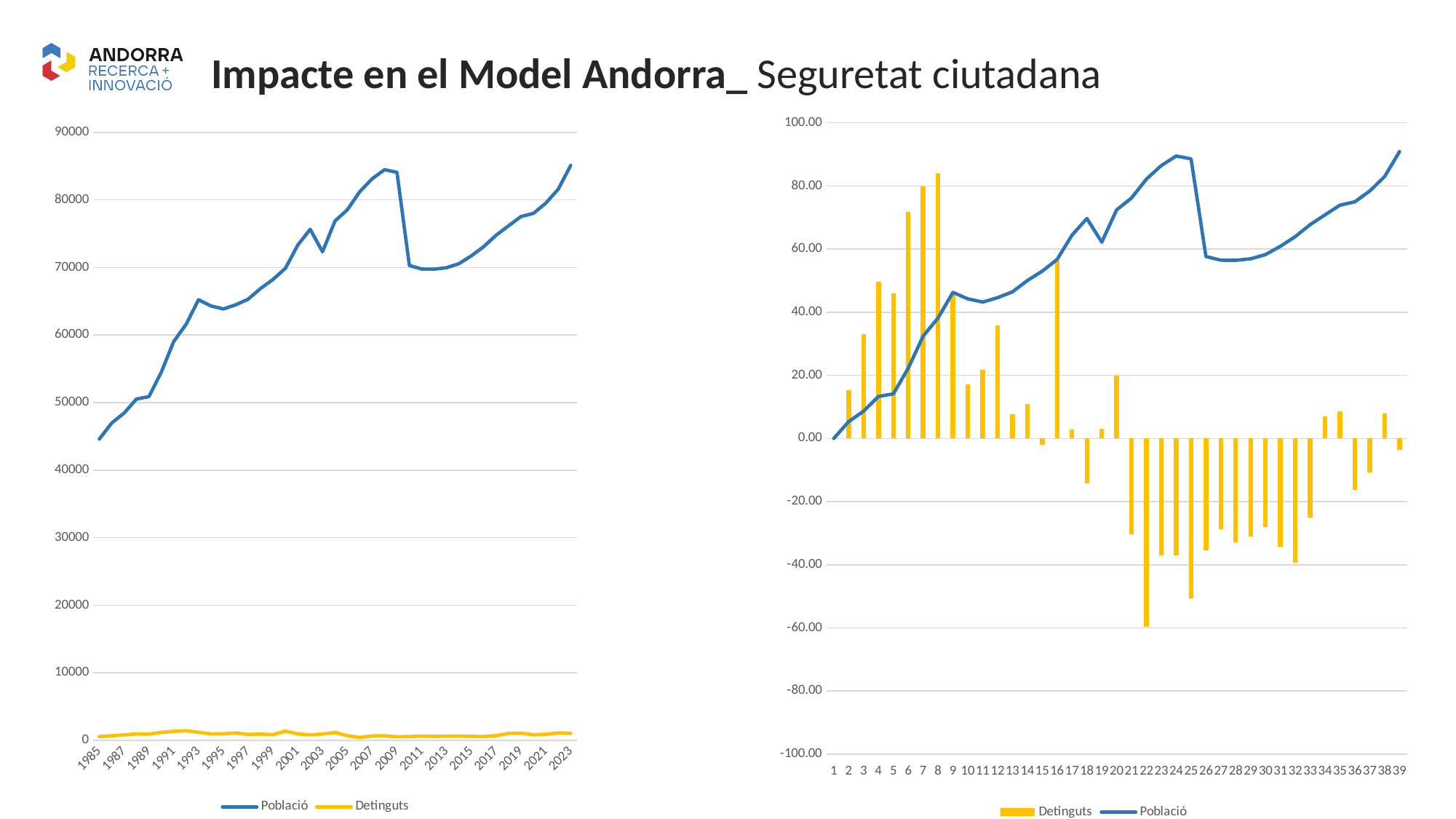
In the left chart, is the value of Població in 2023 greater or less than 80000? greater In the left chart, in which year is Població at its lowest? 1985 In the right chart, at which category is the Detinguts bar lowest? 22 In the right chart, is the Detinguts bar at category 22 greater or less than -40.00? less In the left chart, which series has the larger value in 2023, Població or Detinguts? Població In the left chart, is the value of Població in 1985 greater or less than 50000? less How many series does the legend of the left chart list? 2 What kind of chart is the left chart on the slide? line chart In the right chart, which series is drawn as bars? Detinguts In the left chart, does Població generally rise or fall from 1985 to 2023? rise What are the two series named in the legend of the right chart? Detinguts and Població How many categories are shown on the x axis of the right chart? 39